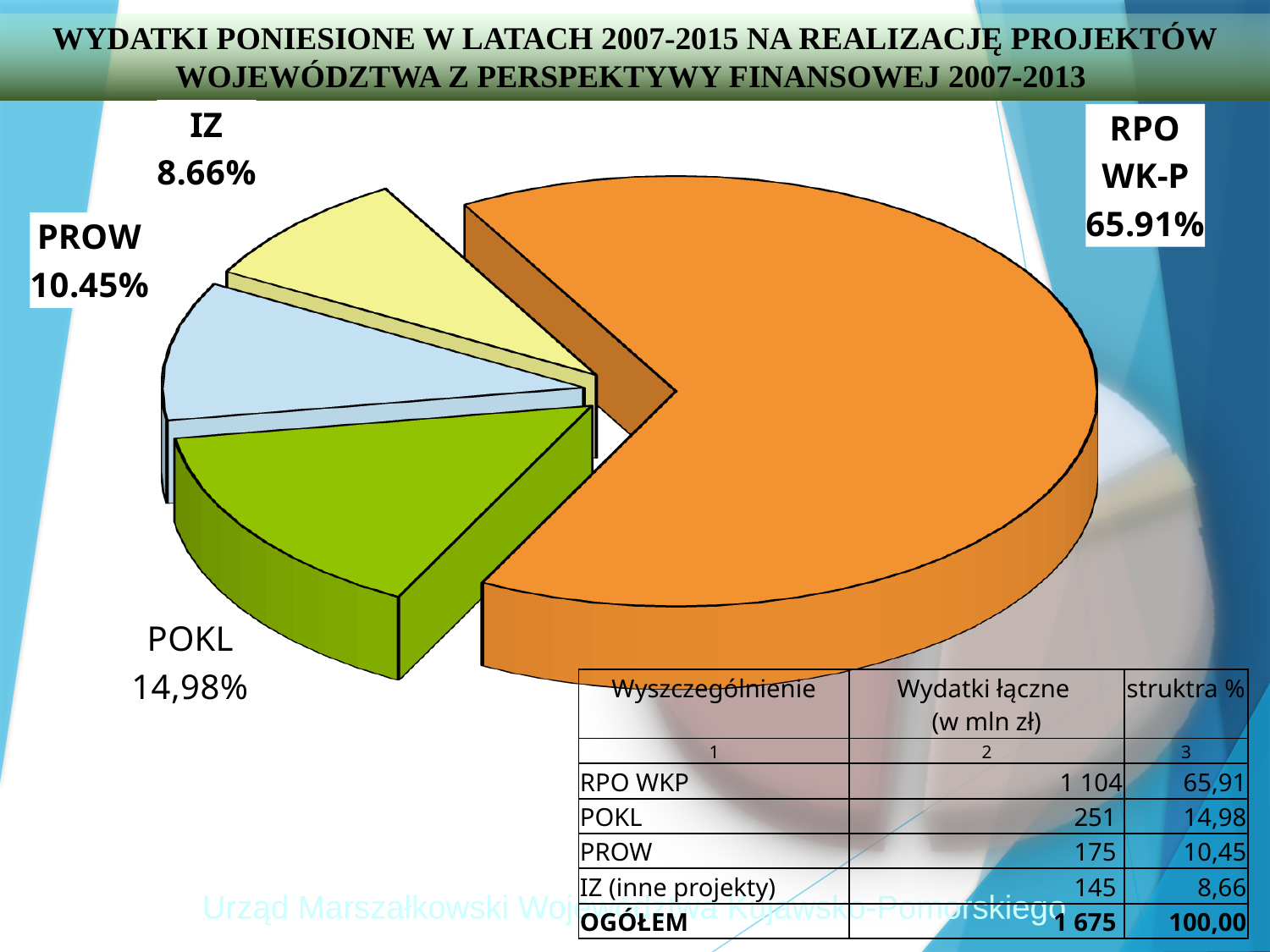
Which is larger, the PROW slice or the POKL slice? POKL What share of the pie does RPO WK-P have? 65.91% What is the difference in percentage points between the RPO WK-P share and the POKL share? 50.93 Which slice of the pie is the smallest? IZ How many slices does the pie chart have? 4 What colour is the RPO WK-P slice of the pie? orange What share of the pie does IZ have? 8.66% Which slice of the pie is the largest? RPO WK-P What share of the pie does PROW have? 10.45% What share of the pie does POKL have? 14,98% What kind of chart is shown on the slide? pie chart What colour is the POKL slice of the pie? green